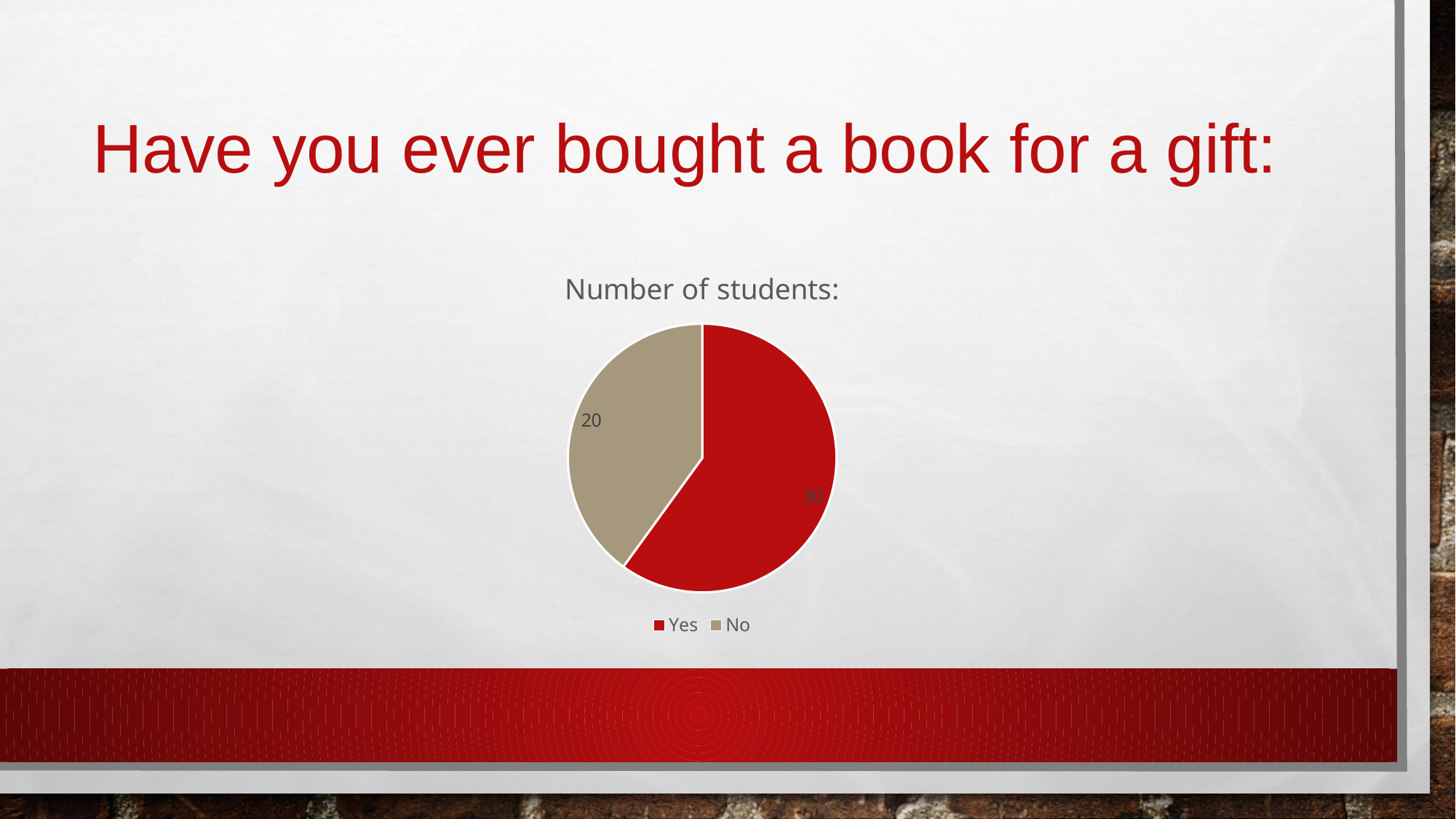
What is the title of the chart? Number of students: Which is larger, the Yes slice or the No slice? Yes Which category has the smallest slice of the pie? No What is the total number of students represented in the pie chart? 50 How many categories does the pie chart show? 2 What colour is the Yes slice in the pie chart? red Which category has the largest slice of the pie? Yes What share of the pie does the Yes slice represent? 60% What type of chart is shown on the slide? pie chart What is the difference between the number of Yes and No answers? 10 How many students answered Yes? 30 How many students answered No? 20